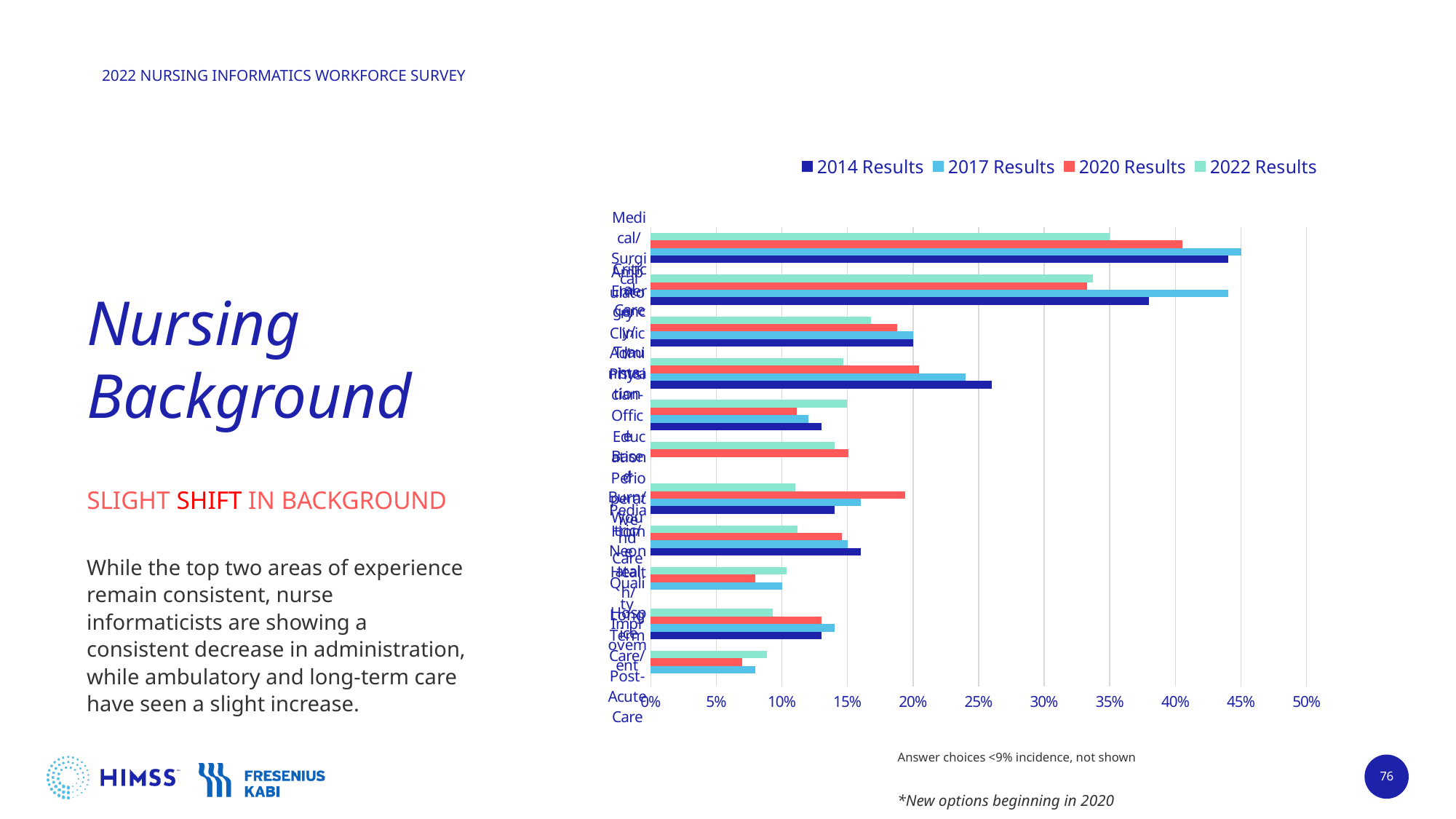
Is the 2017 Results value for the second category from the top greater or less than 40%? greater For the second category from the top, which is larger: the 2017 Results value or the 2020 Results value? 2017 Results Is the 2014 Results value for the second category from the top greater or less than 40%? less For Medical/Surgical, which is larger: the 2014 Results value or the 2022 Results value? 2014 Results Which category has the highest 2022 Results value? Medical/Surgical Is the 2014 Results value for Medical/Surgical greater or less than 40%? greater How many series does the legend list? 4 What is the highest value shown on the x axis of the chart? 50% Which series are listed in the chart legend? 2014 Results, 2017 Results, 2020 Results, 2022 Results What kind of chart is shown on the slide? bar chart